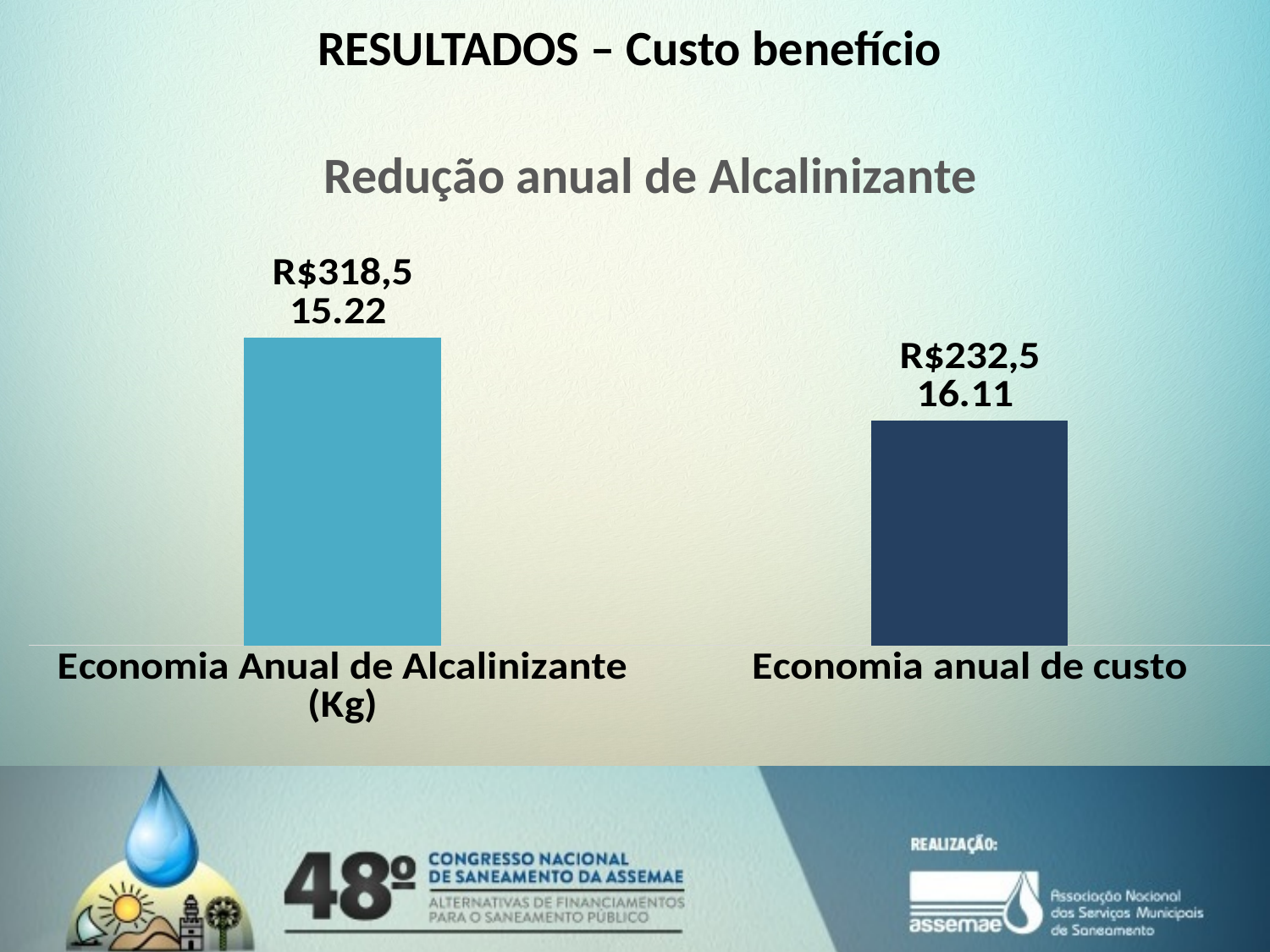
What data label is printed above the bar for 'Economia anual de custo'? R$232,516.11 What is the title of the chart? Redução anual de Alcalinizante What data label is printed above the bar for 'Economia Anual de Alcalinizante (Kg)'? R$318,515.22 What colour is the bar for 'Economia anual de custo'? dark blue What is the label of the first (left) category on the x axis? Economia Anual de Alcalinizante (Kg) Which category has the shorter bar? Economia anual de custo Is the bar for 'Economia Anual de Alcalinizante (Kg)' taller or shorter than the bar for 'Economia anual de custo'? taller How many bars does the chart have? 2 What kind of chart is shown on the slide? bar chart Which category has the taller bar? Economia Anual de Alcalinizante (Kg)